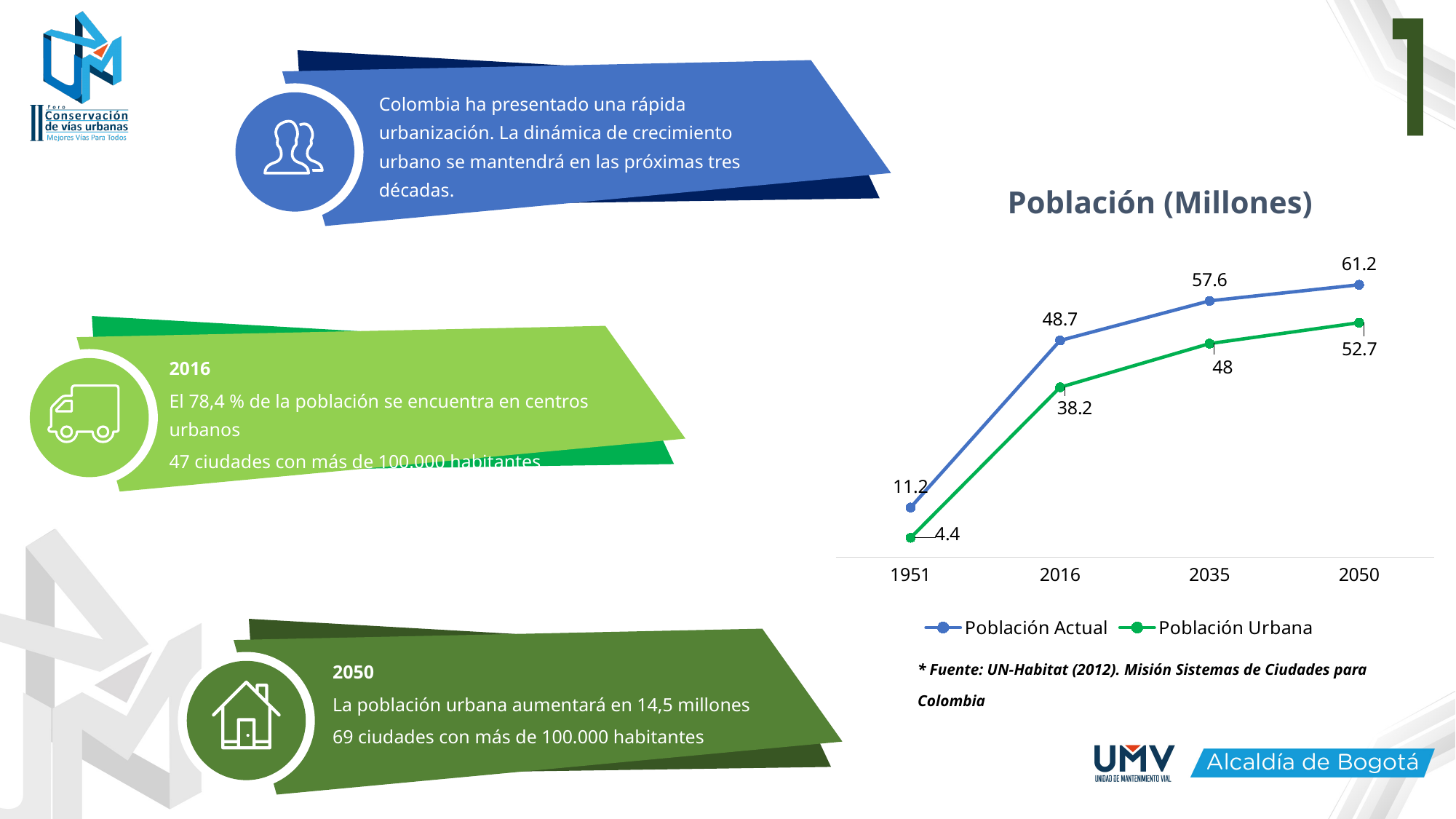
What is the value of Población Actual in 2016? 48.7 How many series does the chart legend list? 2 What is the value of Población Urbana in 1951? 4.4 Does Población Urbana rise or fall from 1951 to 2050? Rise What is the difference between Población Actual and Población Urbana in 2050? 8.5 How many years are shown on the x axis of the chart? 4 In which year is Población Urbana lowest? 1951 In which year is Población Actual highest? 2050 What is the value of Población Urbana in 2050? 52.7 What is the value of Población Actual in 2035? 57.6 What kind of chart is shown on the slide? Line chart Which is larger in 2035, Población Actual or Población Urbana? Población Actual